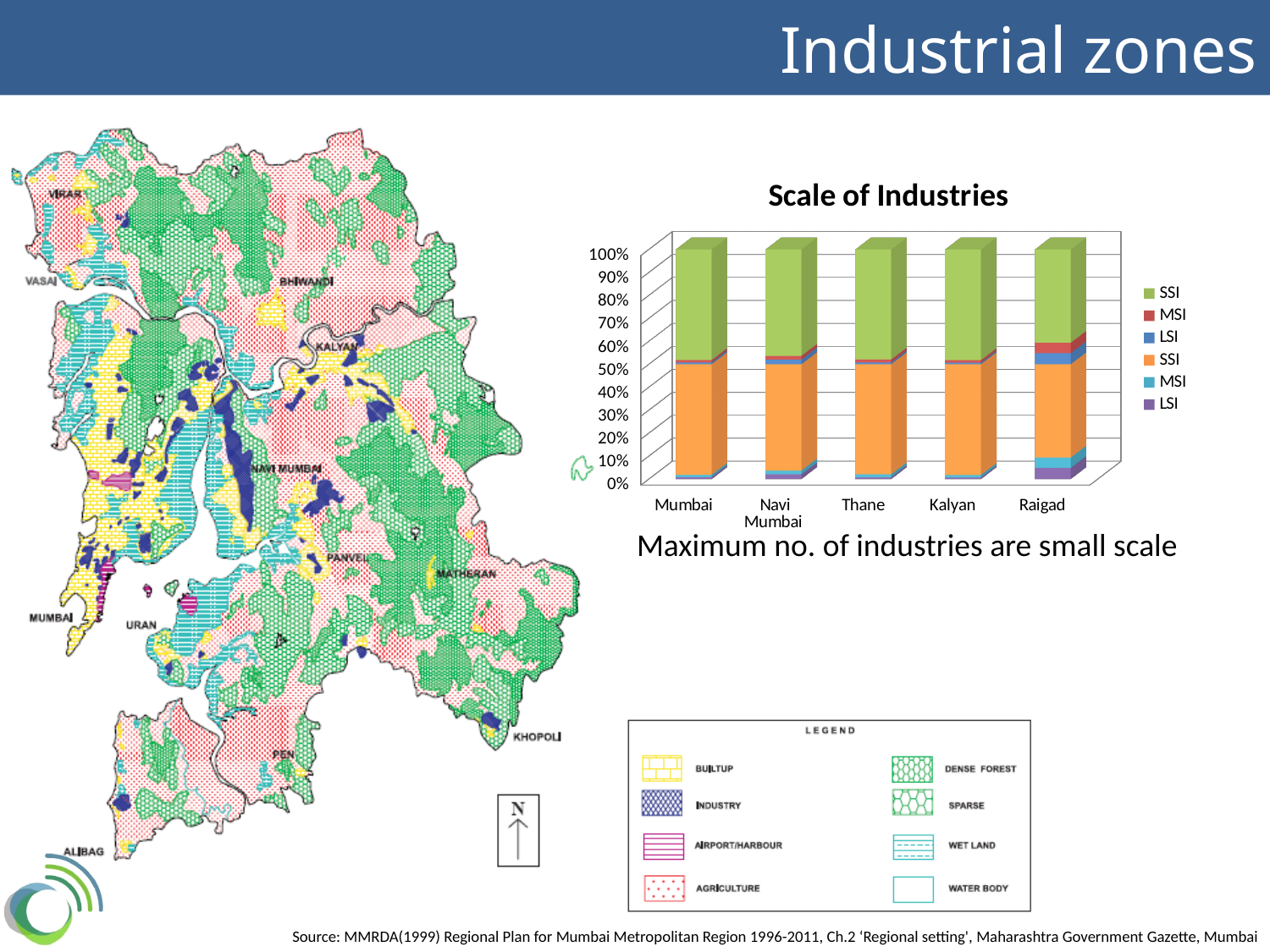
How many entries does the legend of the Scale of Industries chart list? 6 In the Scale of Industries chart, is the purple LSI segment for Raigad larger or smaller than the purple LSI segment for Thane? larger In the Scale of Industries chart, is the top of the orange SSI segment for Mumbai greater or less than 70%? less How many categories are shown on the x axis of the Scale of Industries chart? 5 In the Scale of Industries chart, is the top of the orange SSI segment for Raigad greater or less than 40%? greater According to the text below the chart, which scale of industry is most numerous? Small scale Which categories appear on the x axis of the Scale of Industries chart? Mumbai, Navi Mumbai, Thane, Kalyan, Raigad Which category has the largest purple LSI segment in the Scale of Industries chart? Raigad Which category has the largest red MSI segment in the Scale of Industries chart? Raigad What is the total height of each stacked bar in the Scale of Industries chart? 100% What is the title of the chart on the slide? Scale of Industries What type of chart is shown on the slide? Stacked bar chart